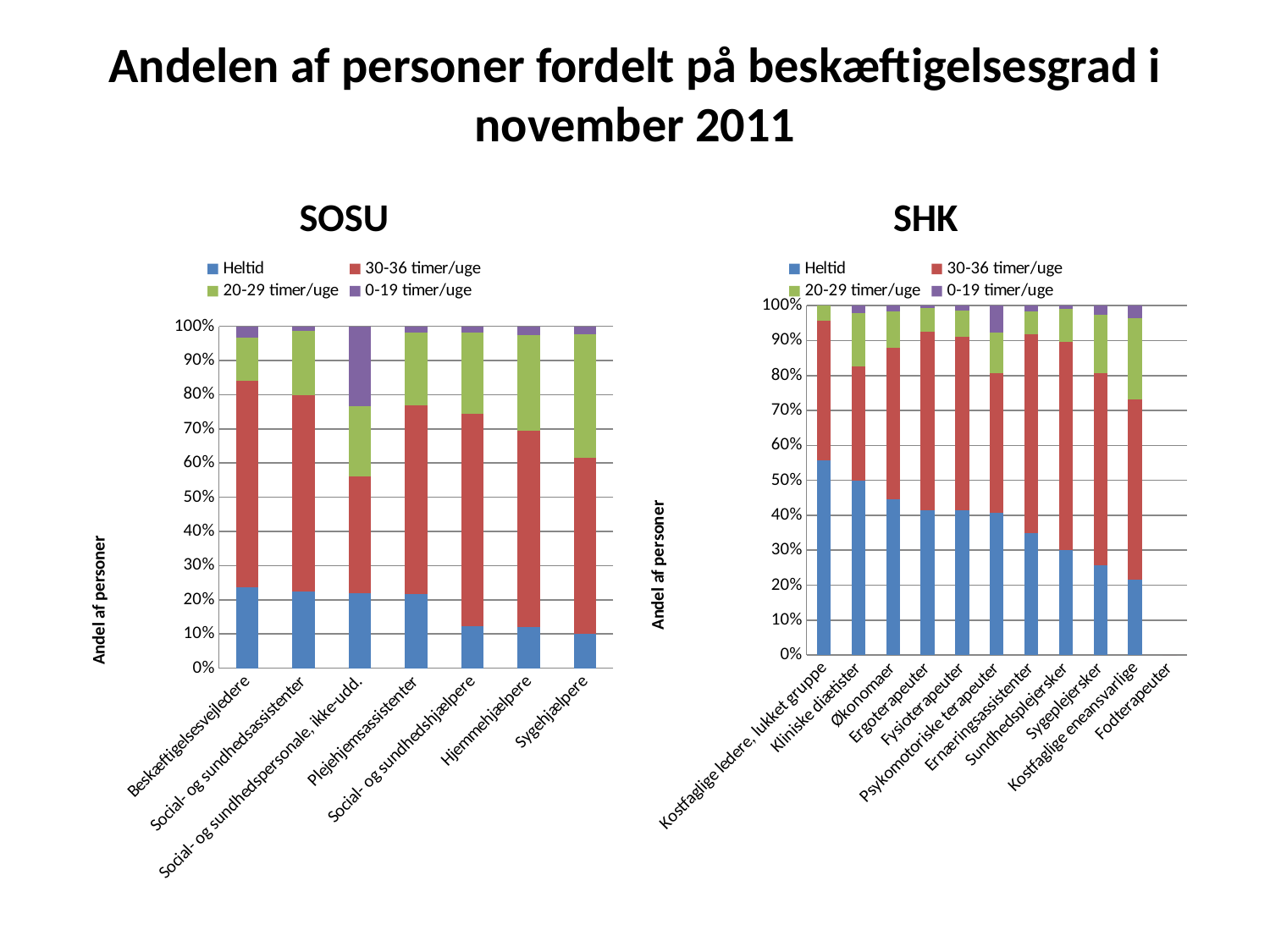
In the SHK chart, is the Heltid share for Sundhedsplejersker greater or less than 40%? less What kind of chart is the SOSU chart? Stacked bar chart How many series does the legend of the SHK chart list? 4 In the SHK chart, is the Heltid share for Kostfaglige ledere, lukket gruppe greater or less than 50%? greater What is the y-axis title of the SOSU chart? Andel af personer In the SOSU chart, is the Heltid share for Beskæftigelsesvejledere greater or less than 20%? greater How many categories are listed on the x axis of the SHK chart? 11 In the SOSU chart, which category has the largest 0-19 timer/uge segment? Social- og sundhedspersonale, ikke-udd. How many categories are shown on the x axis of the SOSU chart? 7 In the SHK chart, which has the larger Heltid share: Kliniske diætister or Sygeplejersker? Kliniske diætister In the SHK chart, which category has the largest Heltid share? Kostfaglige ledere, lukket gruppe